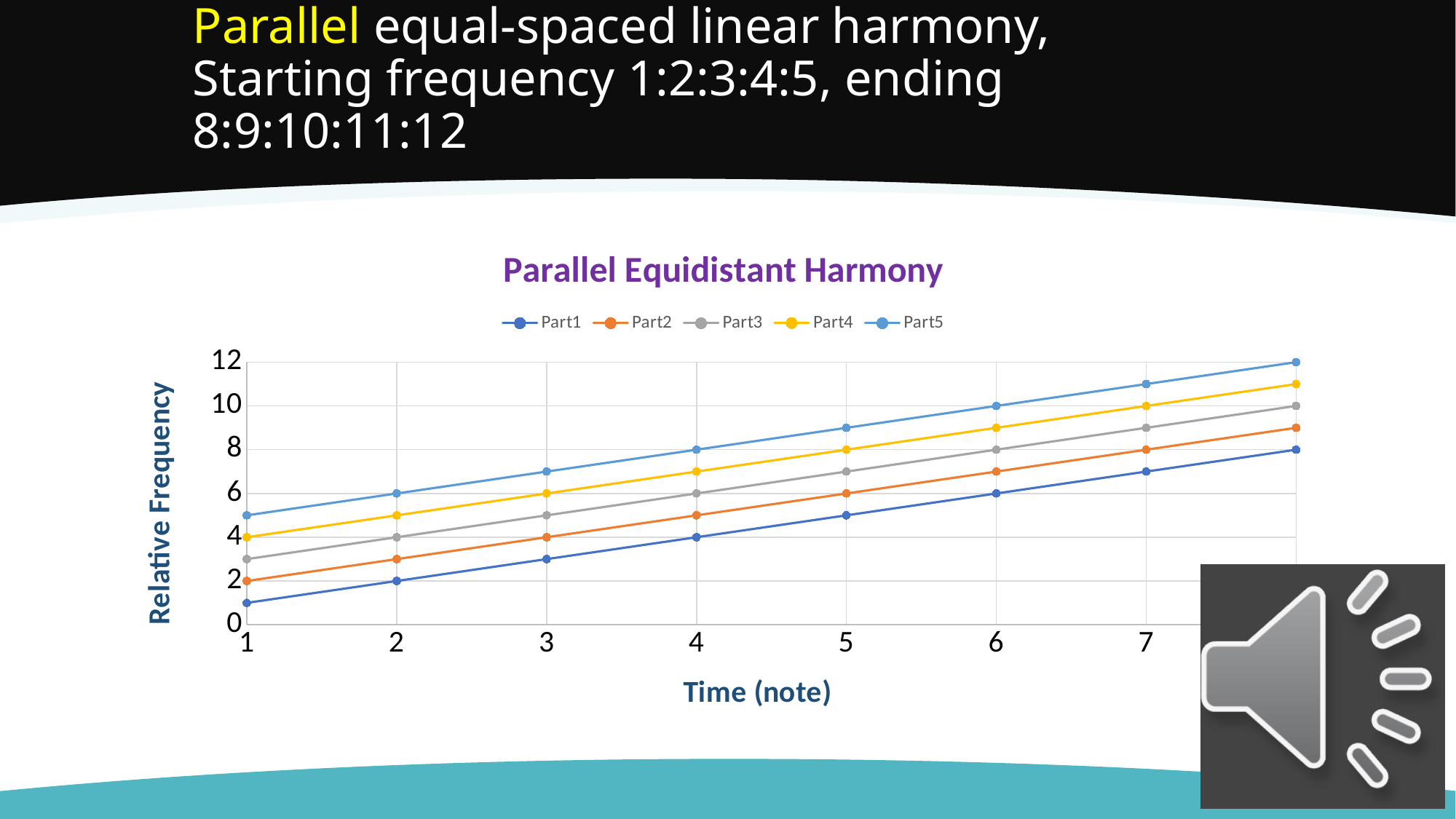
What is the value of Part3 at time 2? 4 What is the title of the chart? Parallel Equidistant Harmony Which series has the highest value at time 4? Part5 Do the values of Part2 rise or fall as time increases? rise What type of chart is shown on the slide? line chart Is the value for Part1 at time 7 greater or less than 6? greater What is the value of Part4 at time 3? 6 How many series does the legend list? 5 What is the value of Part1 at time 2? 2 What is the value of Part5 at time 6? 10 What is the label of the y axis? Relative Frequency Which series has the lowest value at time 7? Part1